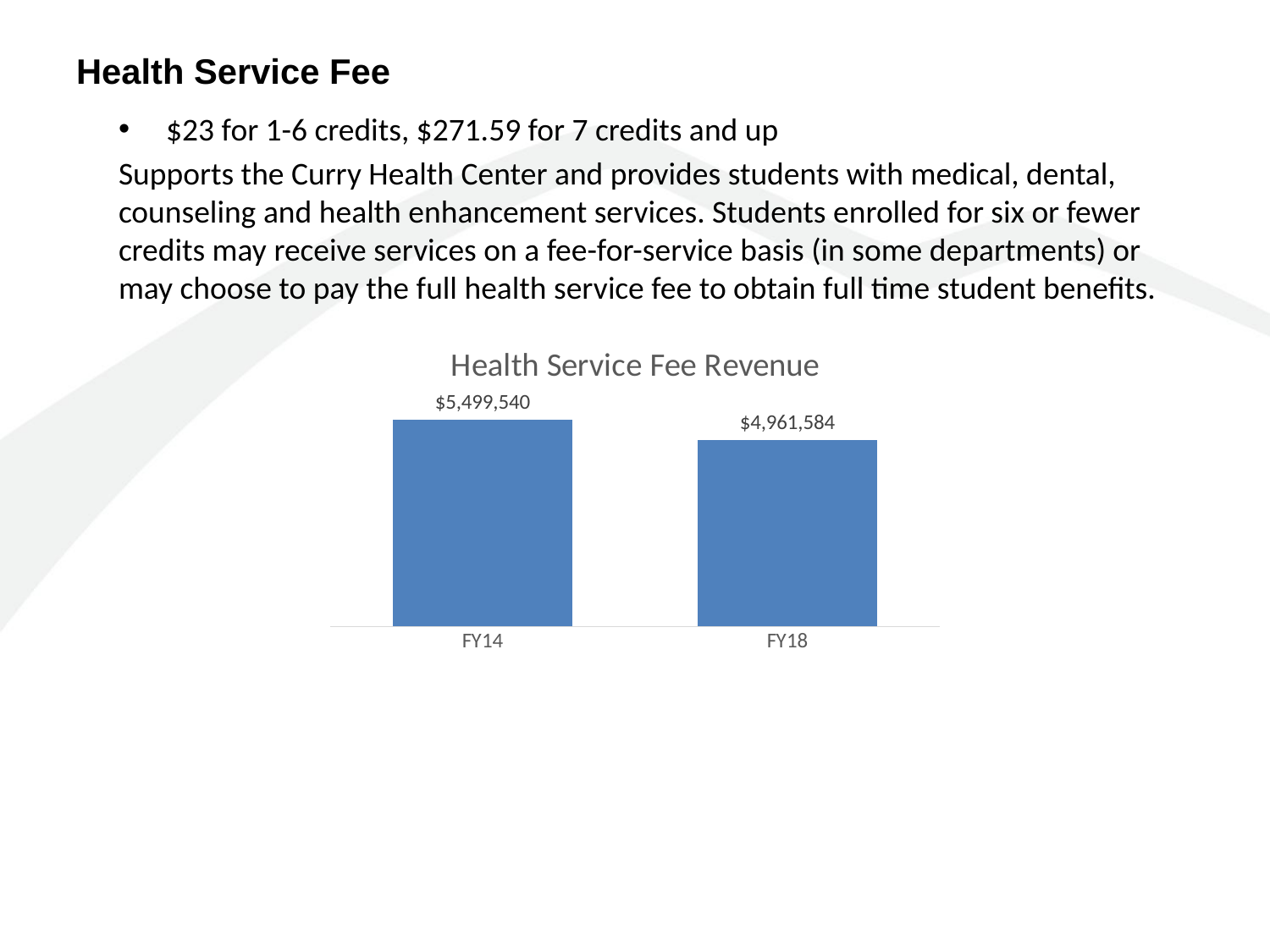
Does the Health Service Fee Revenue rise or fall from FY14 to FY18? Fall What is the Health Service Fee Revenue for FY18? $4,961,584 Which fiscal year has the higher Health Service Fee Revenue? FY14 What is the difference between the FY14 and FY18 Health Service Fee Revenue? $537,956 What is the Health Service Fee Revenue for FY14? $5,499,540 What colour are the bars in the Health Service Fee Revenue chart? Blue What kind of chart is used to show Health Service Fee Revenue? Bar chart How many fiscal years are shown in the Health Service Fee Revenue chart? 2 Is the Health Service Fee Revenue larger in FY14 or FY18? FY14 What is the title of the chart on the slide? Health Service Fee Revenue Which fiscal year has the lower Health Service Fee Revenue? FY18